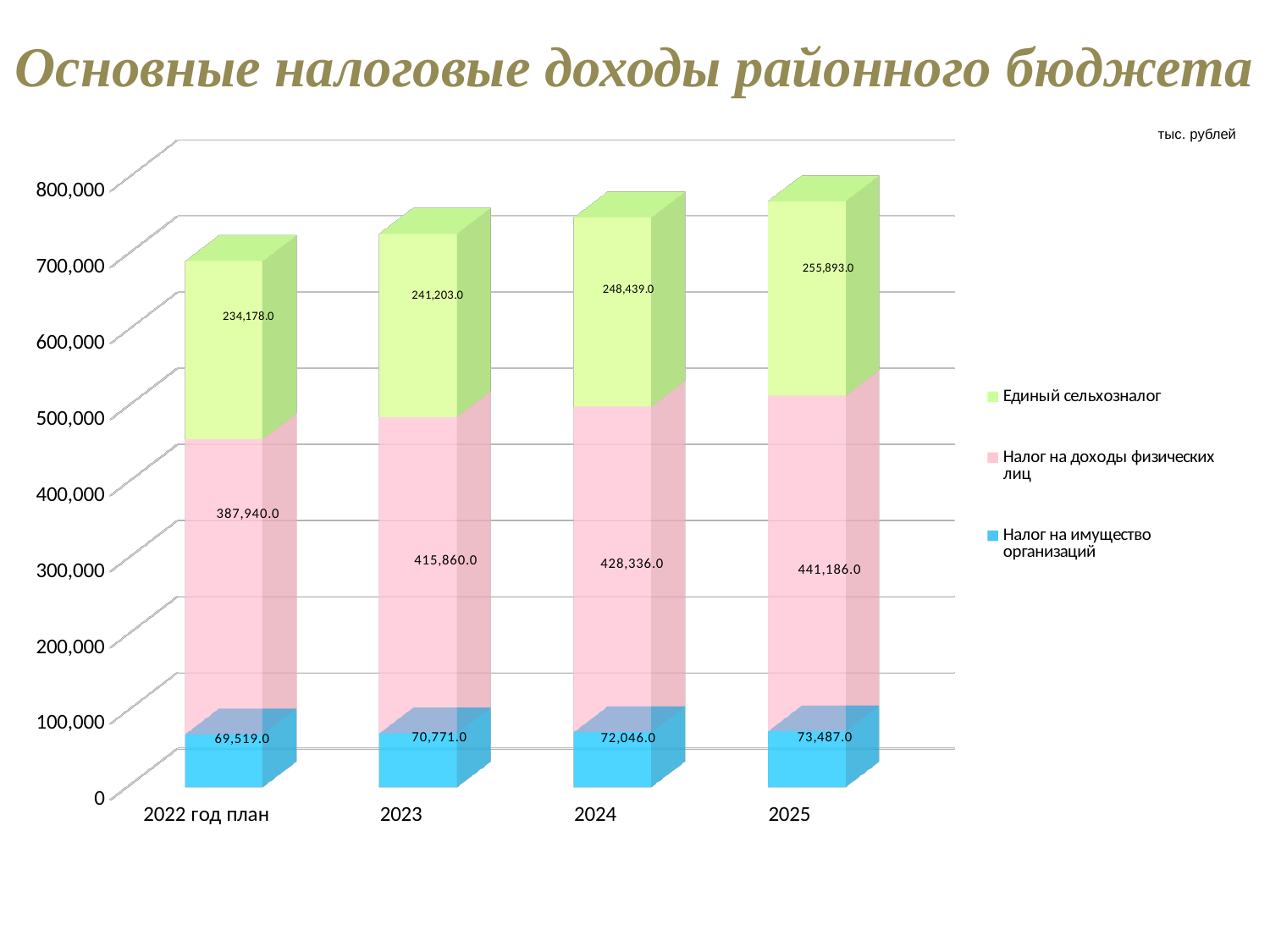
How many categories are shown on the x axis? 4 Do the values of Налог на имущество организаций rise or fall from 2022 год план to 2025? Rise What is the value of Налог на доходы физических лиц for 2023? 415,860.0 Which is larger: Единый сельхозналог in 2024 or Налог на имущество организаций in 2024? Единый сельхозналог in 2024 In which year is Налог на доходы физических лиц the highest? 2025 What is the difference between Налог на доходы физических лиц in 2025 and in 2022 год план? 53,246.0 In which category is Единый сельхозналог the lowest? 2022 год план What is the value of Налог на имущество организаций for 2022 год план? 69,519.0 What is the total of the stacked bar for 2023? 727,834.0 What is the value of Единый сельхозналог for 2025? 255,893.0 How many series does the legend list? 3 What kind of chart is shown on the slide? Stacked bar chart